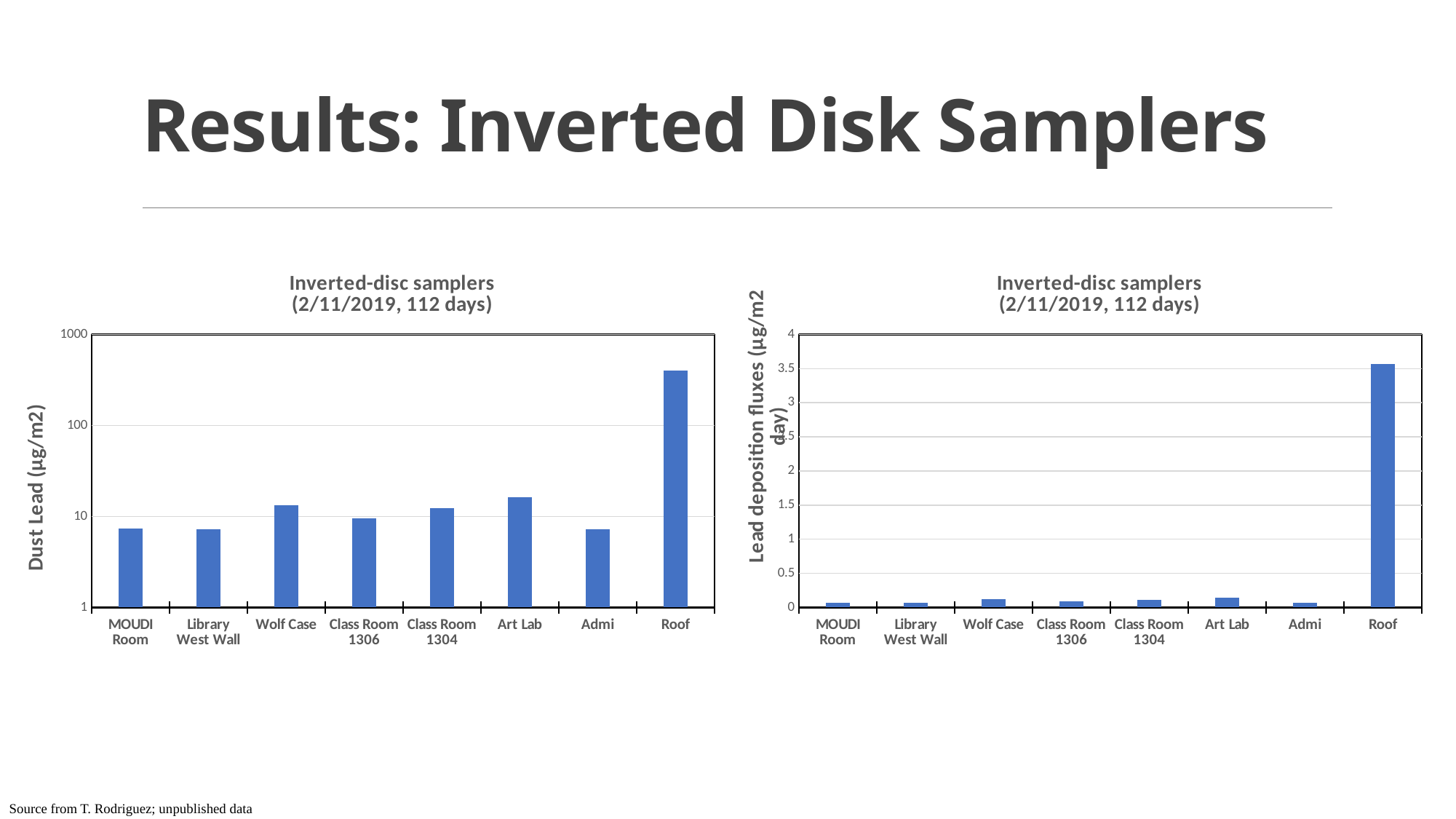
On the left chart (Dust Lead), is the value for Art Lab greater or less than 10? greater What kind of chart is the right chart (Lead deposition fluxes)? bar chart On the left chart (Dust Lead), which is larger, the value for Art Lab or the value for Class Room 1306? Art Lab On the right chart (Lead deposition fluxes), which location has the highest value? Roof What is the y-axis title of the left chart? Dust Lead (µg/m2) How many locations are shown on the x axis of the left chart (Dust Lead)? 8 On the right chart (Lead deposition fluxes), is the value for Art Lab greater or less than 0.5? less On the left chart (Dust Lead), is the value for Roof greater or less than 100? greater On the right chart (Lead deposition fluxes), which is larger, the value for Roof or the value for Wolf Case? Roof On the left chart (Dust Lead), which location has the highest value? Roof